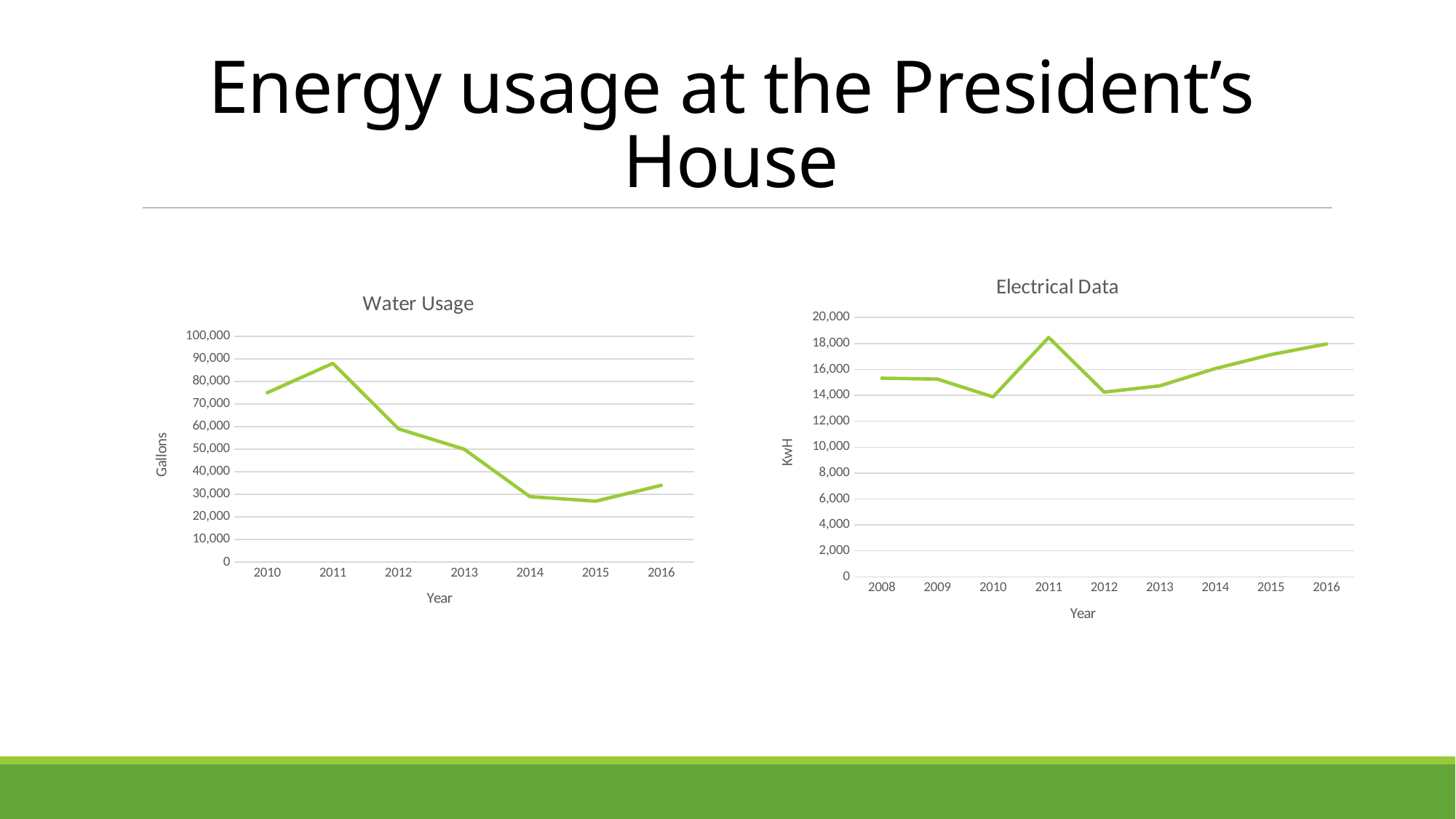
In the Water Usage chart, which year has the larger value, 2012 or 2013? 2012 In the Water Usage chart, does water usage overall rise or fall from 2010 to 2016? fall In the Electrical Data chart, is the value for 2016 greater or less than 16,000? greater In the Electrical Data chart, how many years are plotted on the x axis? 9 In the Water Usage chart, how many years are plotted on the x axis? 7 What kind of chart is the Water Usage chart? line chart In the Electrical Data chart, which year has the highest value? 2011 In the Water Usage chart, is the value for 2014 greater or less than 40,000? less What is the y-axis label of the Electrical Data chart? KwH In the Water Usage chart, is the value for 2011 greater or less than 80,000? greater In the Water Usage chart, which year has the highest water usage? 2011 In the Electrical Data chart, which year has the larger value, 2012 or 2014? 2014